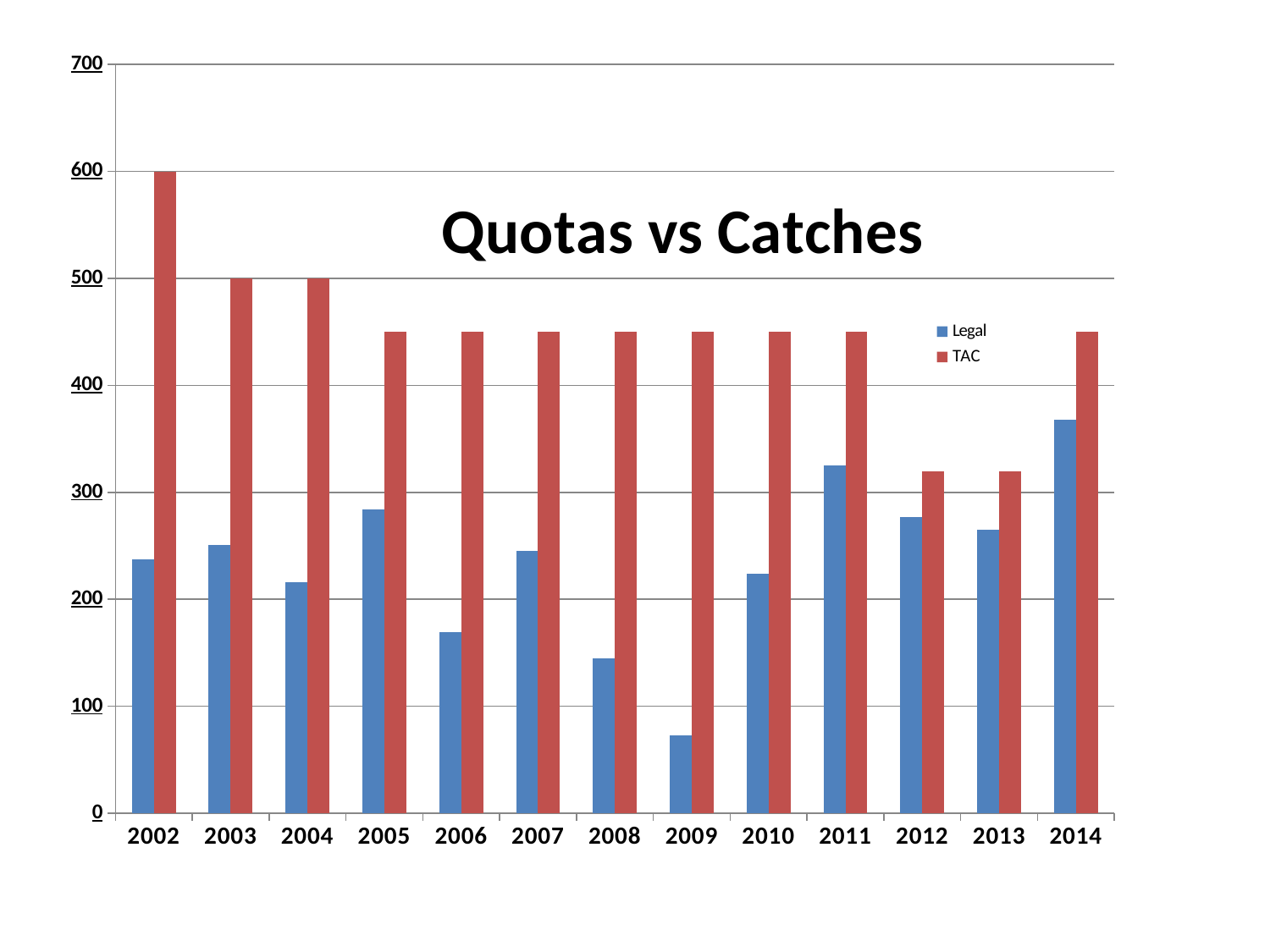
Which is larger, the Legal value for 2005 or the Legal value for 2006? 2005 What kind of chart is shown on the slide? bar chart How many series does the legend list? 2 How many years are shown on the x axis? 13 What is the TAC value for 2002? 600 What is the TAC value for 2003? 500 In which year is the TAC value highest? 2002 What is the difference between the TAC value for 2002 and the TAC value for 2003? 100 In which year is the Legal value highest? 2014 What is the title of the chart? Quotas vs Catches In which year is the Legal value lowest? 2009 Is the Legal value for 2009 greater or less than 100? less